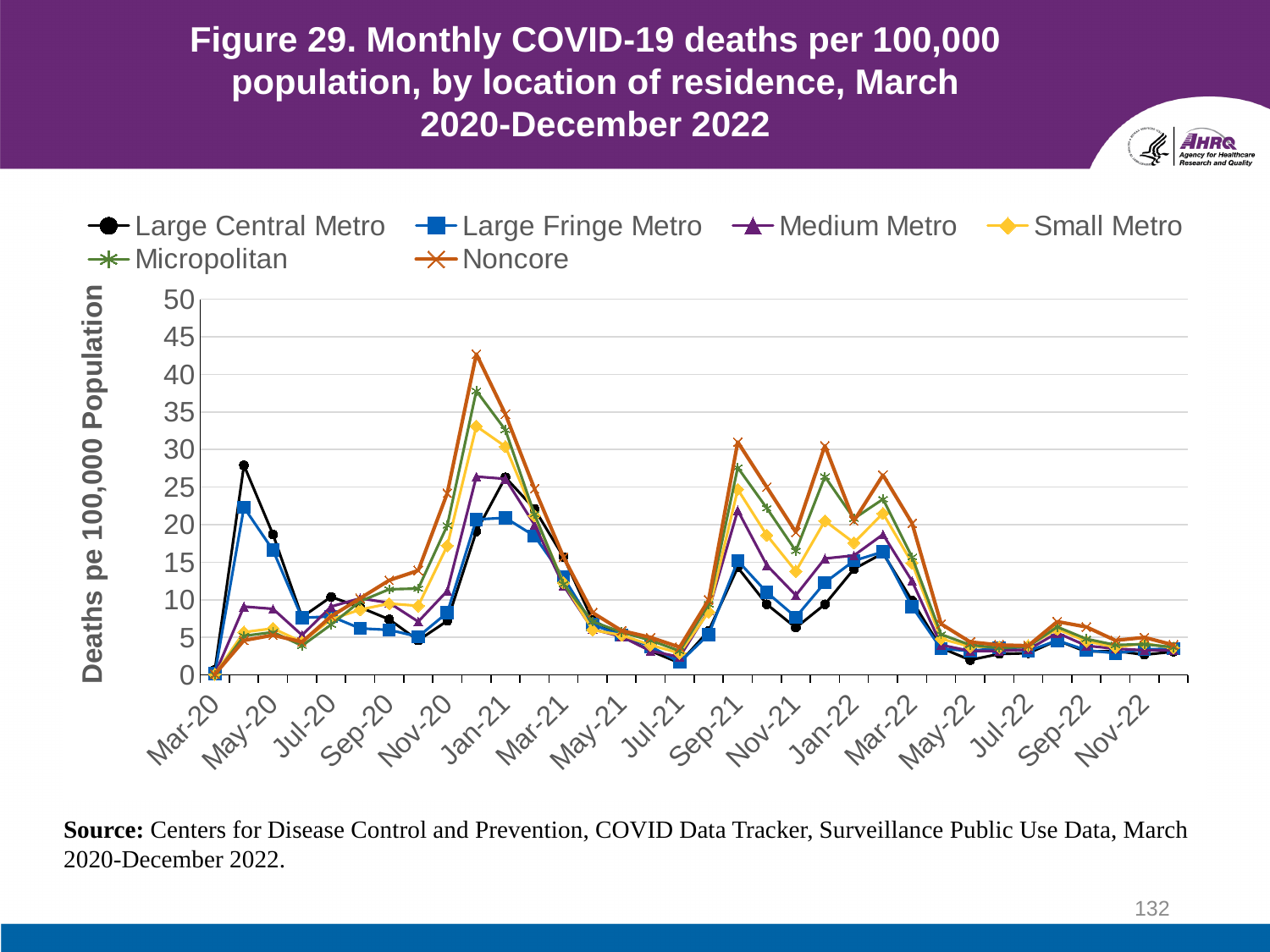
What is the highest value shown on the y axis? 50 Is the value for Large Central Metro in April 2020 greater or less than 25? greater Which series reaches the highest peak value on the chart? Noncore What kind of chart is shown on the slide? line chart Which series has the highest value in April 2020? Large Central Metro Is the value for Micropolitan in December 2020 greater or less than 35? greater Is the value for Small Metro in December 2020 greater or less than 30? greater Do the values for all series rise or fall between January 2021 and June 2021? fall How many series does the legend list? 6 In December 2020, which is larger: the value for Noncore or the value for Large Central Metro? Noncore What is the y-axis label of the chart? Deaths pe 100,000 Population